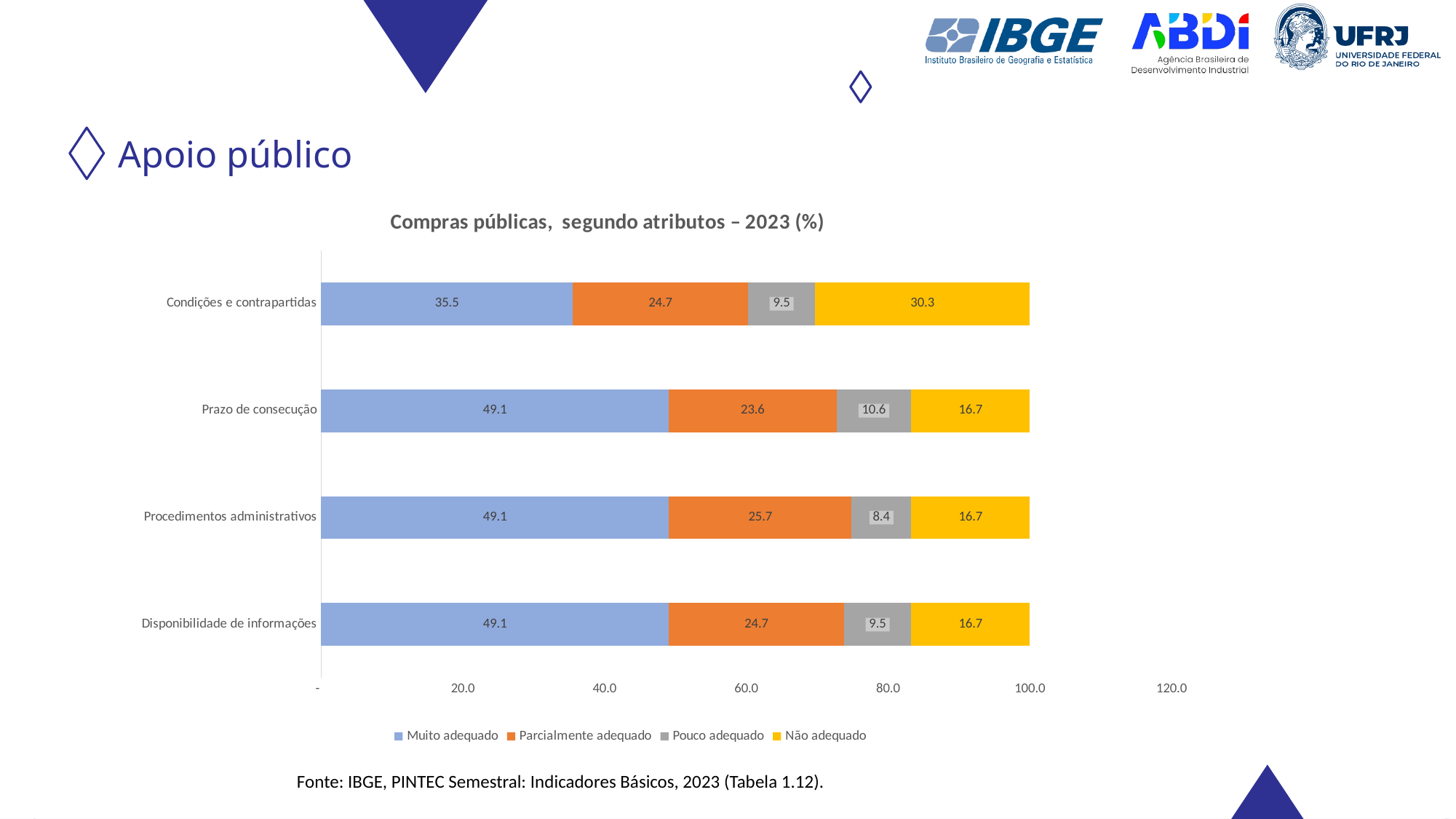
How many series does the legend list? 4 What is the value of "Não adequado" for "Condições e contrapartidas"? 30.3 Which category has the highest value for "Não adequado"? Condições e contrapartidas What is the value of "Muito adequado" for "Condições e contrapartidas"? 35.5 Which is larger: the "Pouco adequado" value for "Prazo de consecução" or for "Procedimentos administrativos"? Prazo de consecução What is the difference between the "Não adequado" values for "Condições e contrapartidas" and "Prazo de consecução"? 13.6 Which category has the lowest value for "Muito adequado"? Condições e contrapartidas What is the title of the chart? Compras públicas, segundo atributos – 2023 (%) What is the value of "Parcialmente adequado" for "Procedimentos administrativos"? 25.7 What is the value of "Pouco adequado" for "Prazo de consecução"? 10.6 How many categories are shown on the chart? 4 What kind of chart is shown on the slide? Stacked bar chart